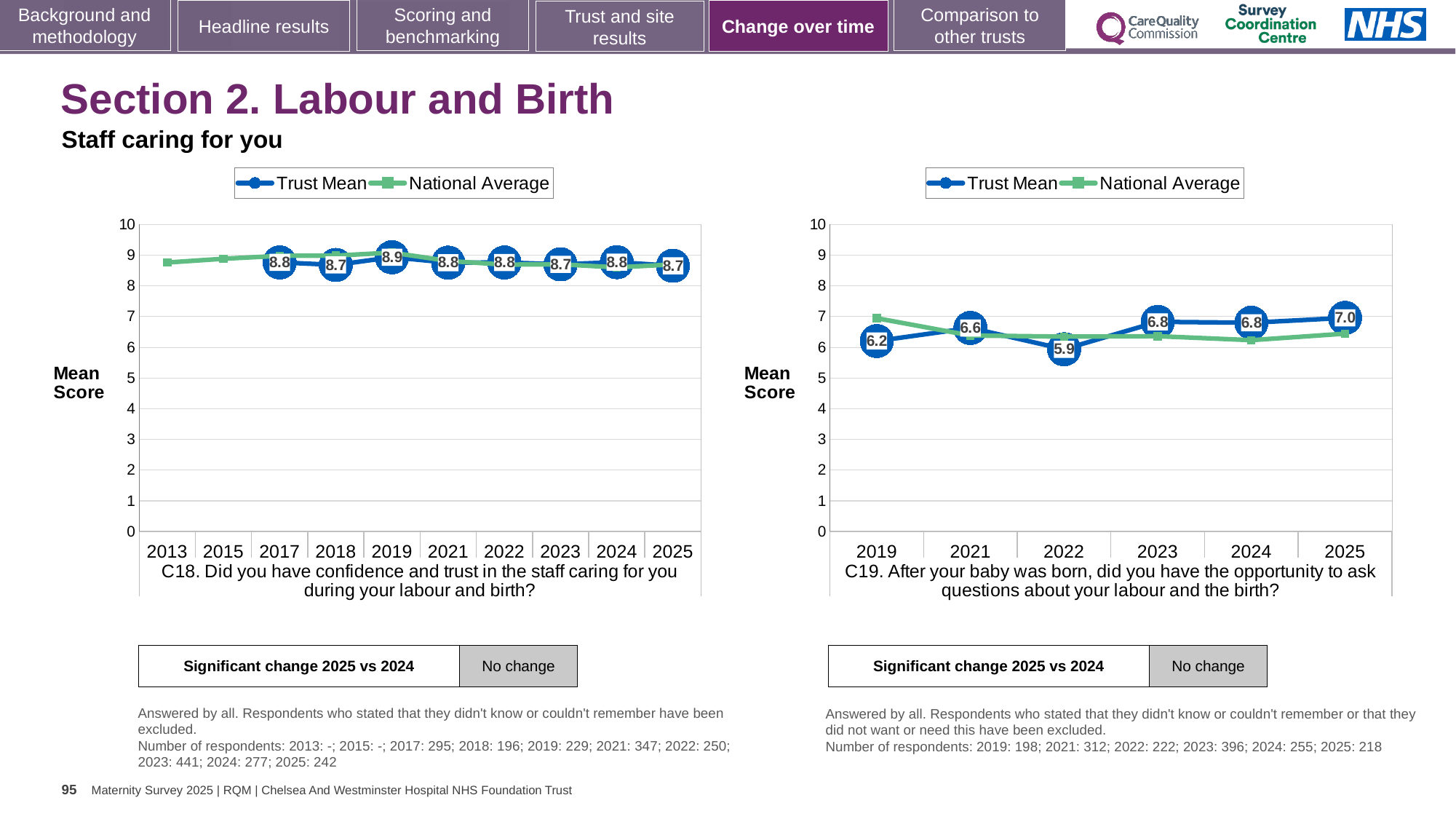
In the C19 chart on the right, is the Trust Mean higher in 2021 or in 2022? 2021 In the C19 chart on the right, is the National Average for 2019 greater or less than 6? greater In the C19 chart on the right, what is the difference between the Trust Mean for 2025 and the Trust Mean for 2019? 0.8 How many series does the legend of the C19 chart on the right list? 2 In the C19 chart on the right, does the Trust Mean rise or fall from 2022 to 2025? Rise In the C18 chart on the left, what is the Trust Mean for 2025? 8.7 In the C18 chart on the left, what is the Trust Mean for 2019? 8.9 In the C19 chart on the right, which year has the highest Trust Mean? 2025 What type of chart is the C18 chart on the left? Line chart In the C19 chart on the right, which year has the lowest Trust Mean? 2022 How many years are shown on the x axis of the C18 chart on the left? 10 In the C19 chart on the right, what is the Trust Mean for 2022? 5.9